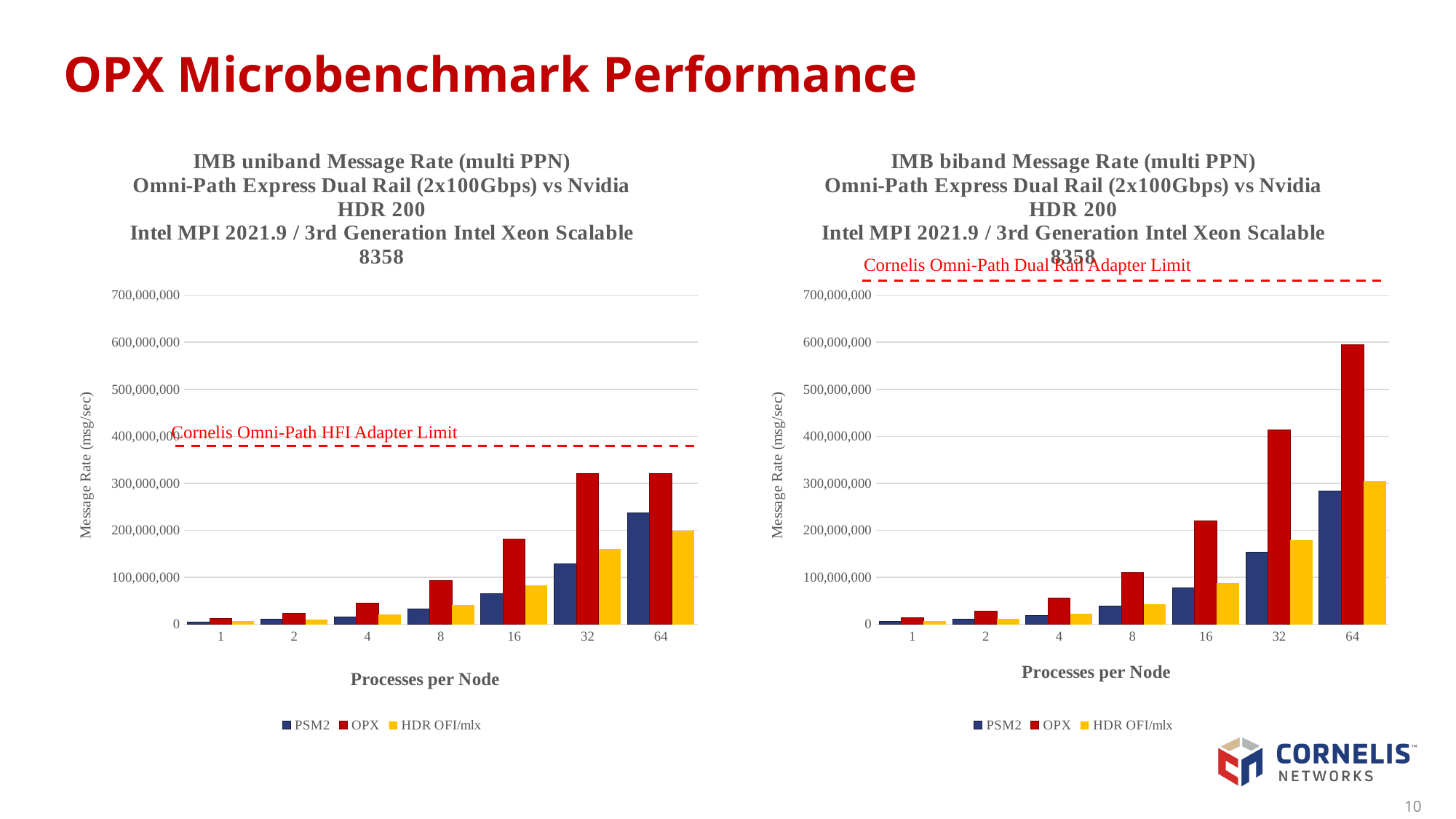
How many series does the legend of the IMB biband Message Rate chart on the right list? 3 In the IMB uniband chart on the left, is the OPX value at 64 processes per node greater or less than 300,000,000? greater In the IMB biband chart on the right, does the OPX message rate rise or fall as processes per node increase from 1 to 64? rise What label is given to the red dashed line in the IMB uniband chart on the left? Cornelis Omni-Path HFI Adapter Limit In the IMB biband chart on the right, at 32 processes per node, which is larger: OPX or HDR OFI/mlx? OPX In the IMB uniband chart on the left, at 64 processes per node, which is larger: PSM2 or HDR OFI/mlx? PSM2 What type of chart is the IMB uniband Message Rate chart on the left? bar chart In the IMB biband chart on the right, is the OPX value at 64 processes per node greater or less than 500,000,000? greater In the IMB uniband chart on the left, is the PSM2 value at 64 processes per node greater or less than 300,000,000? less How many Processes per Node categories are shown on the x axis of the IMB uniband chart on the left? 7 In the IMB biband chart on the right, which series has the highest message rate at 64 processes per node? OPX In the IMB uniband chart on the left, which series has the lowest message rate at 64 processes per node? HDR OFI/mlx